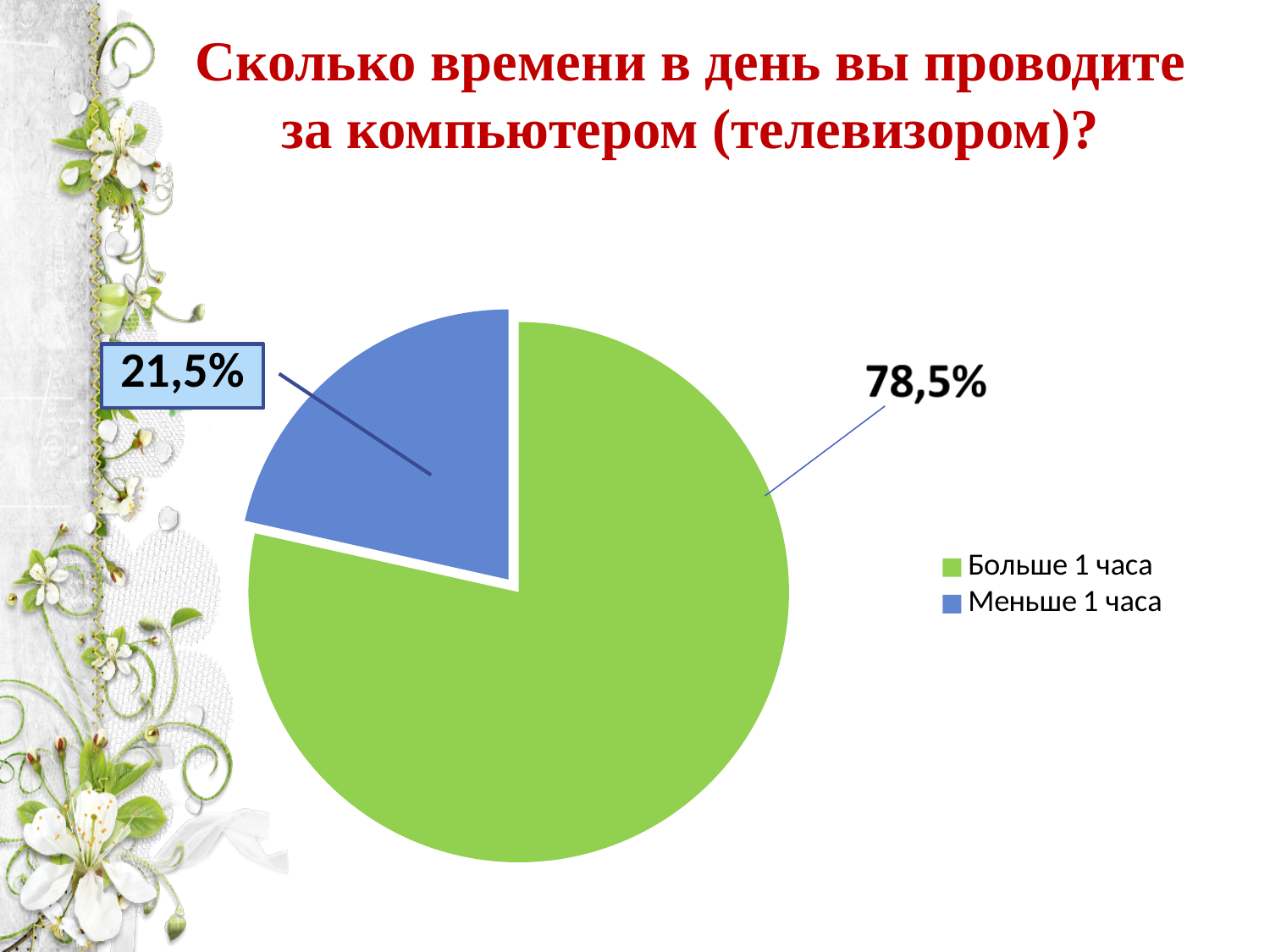
What colour is the "Меньше 1 часа" slice? blue Which slice is larger: "Больше 1 часа" or "Меньше 1 часа"? Больше 1 часа What is the difference in percentage points between the "Больше 1 часа" and "Меньше 1 часа" slices? 57 percentage points How many entries does the legend list? 2 How many slices does the pie chart have? 2 What colour is the "Больше 1 часа" slice? green Which category has the largest slice of the pie? Больше 1 часа What kind of chart is shown on the slide? pie chart What share of the pie is labelled "Больше 1 часа"? 78,5% What share of the pie is labelled "Меньше 1 часа"? 21,5% Which category has the smallest slice of the pie? Меньше 1 часа